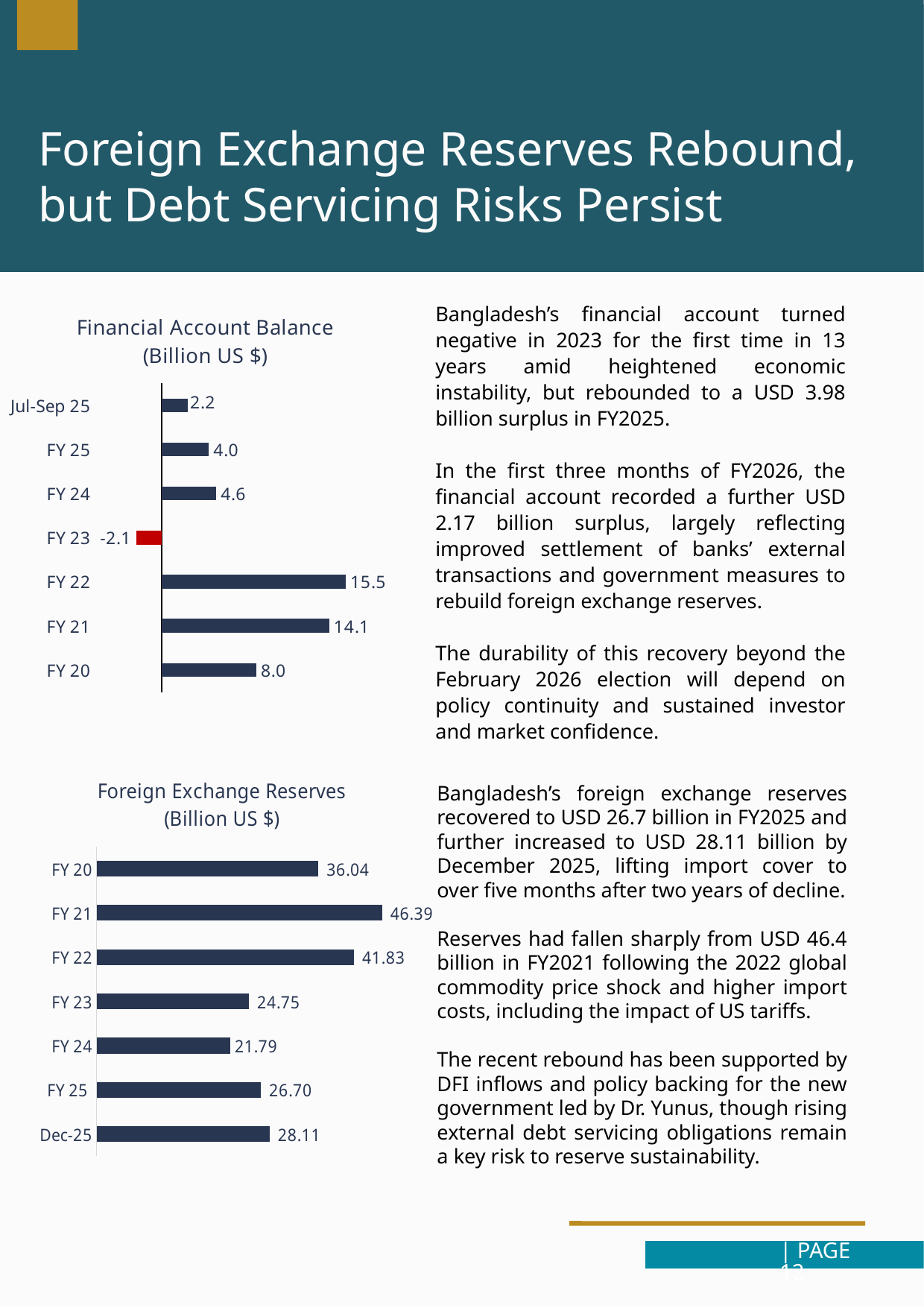
In the Foreign Exchange Reserves chart, which category has the lowest value? FY 24 In the Financial Account Balance chart, what is the value for FY 23? -2.1 In the Financial Account Balance chart, which category has the highest value? FY 22 In the Financial Account Balance chart, which bar is shown in red? FY 23 In the Financial Account Balance chart, which category has the lowest value? FY 23 In the Foreign Exchange Reserves chart, which category has the highest value? FY 21 In the Financial Account Balance chart, what is the difference between FY 22 and FY 21? 1.4 In the Financial Account Balance chart, how many categories are plotted? 7 In the Financial Account Balance chart, what is the value for FY 22? 15.5 What kind of chart is the Foreign Exchange Reserves chart? Bar chart In the Foreign Exchange Reserves chart, which is larger, FY 25 or Dec-25? Dec-25 In the Foreign Exchange Reserves chart, what is the value for FY 24? 21.79